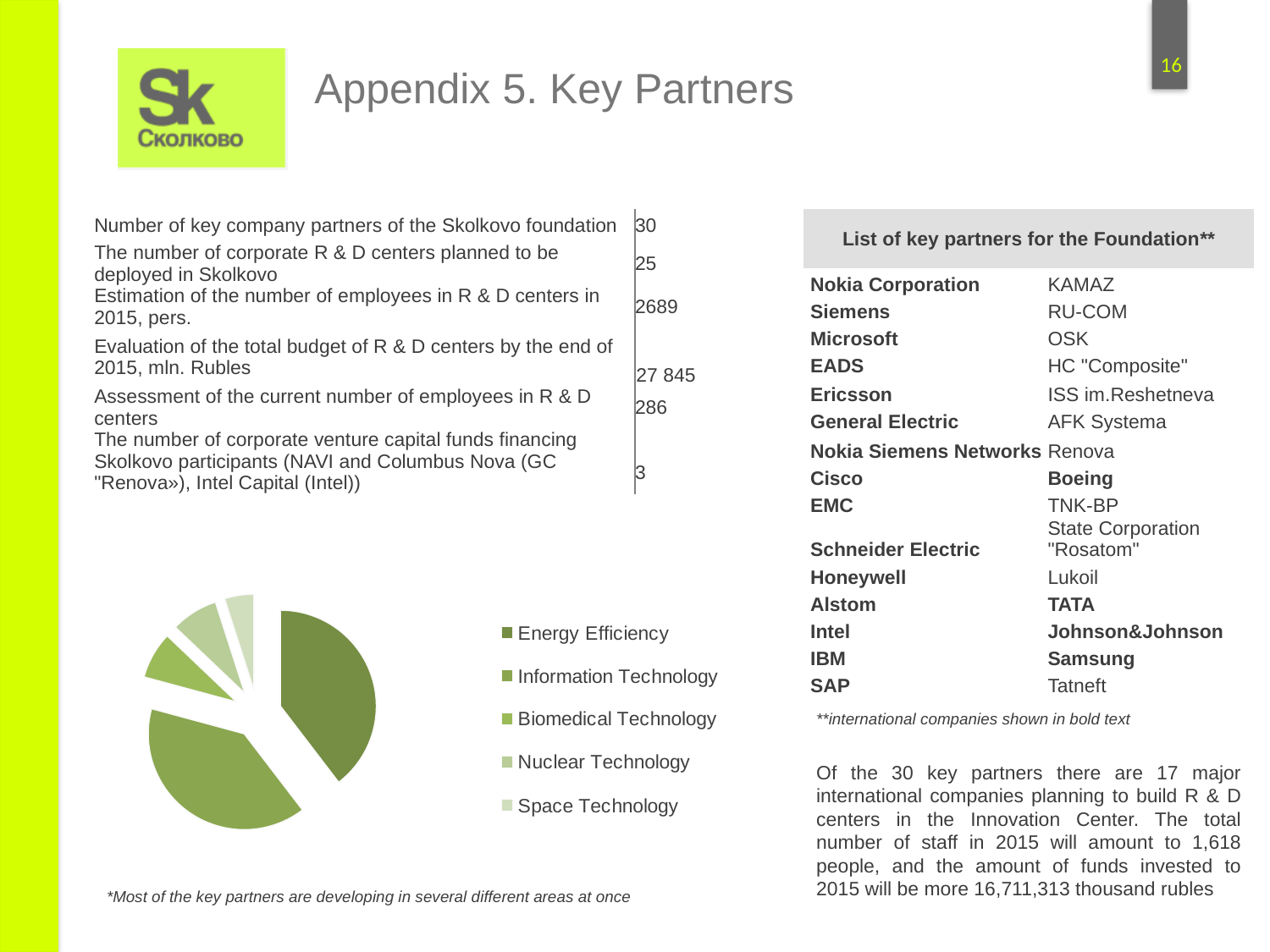
How many entries does the pie chart's legend list? 5 Which category has the smallest slice in the pie chart? Space Technology In the pie chart, which slice is larger: Biomedical Technology or Space Technology? Biomedical Technology What does the footnote below the pie chart say? *Most of the key partners are developing in several different areas at once What kind of chart is shown on the slide? pie chart In the pie chart, which slice is larger: Energy Efficiency or Nuclear Technology? Energy Efficiency In the pie chart, which slice is larger: Information Technology or Biomedical Technology? Information Technology How many slices does the pie chart have? 5 Which legend entry is listed first in the pie chart's legend? Energy Efficiency